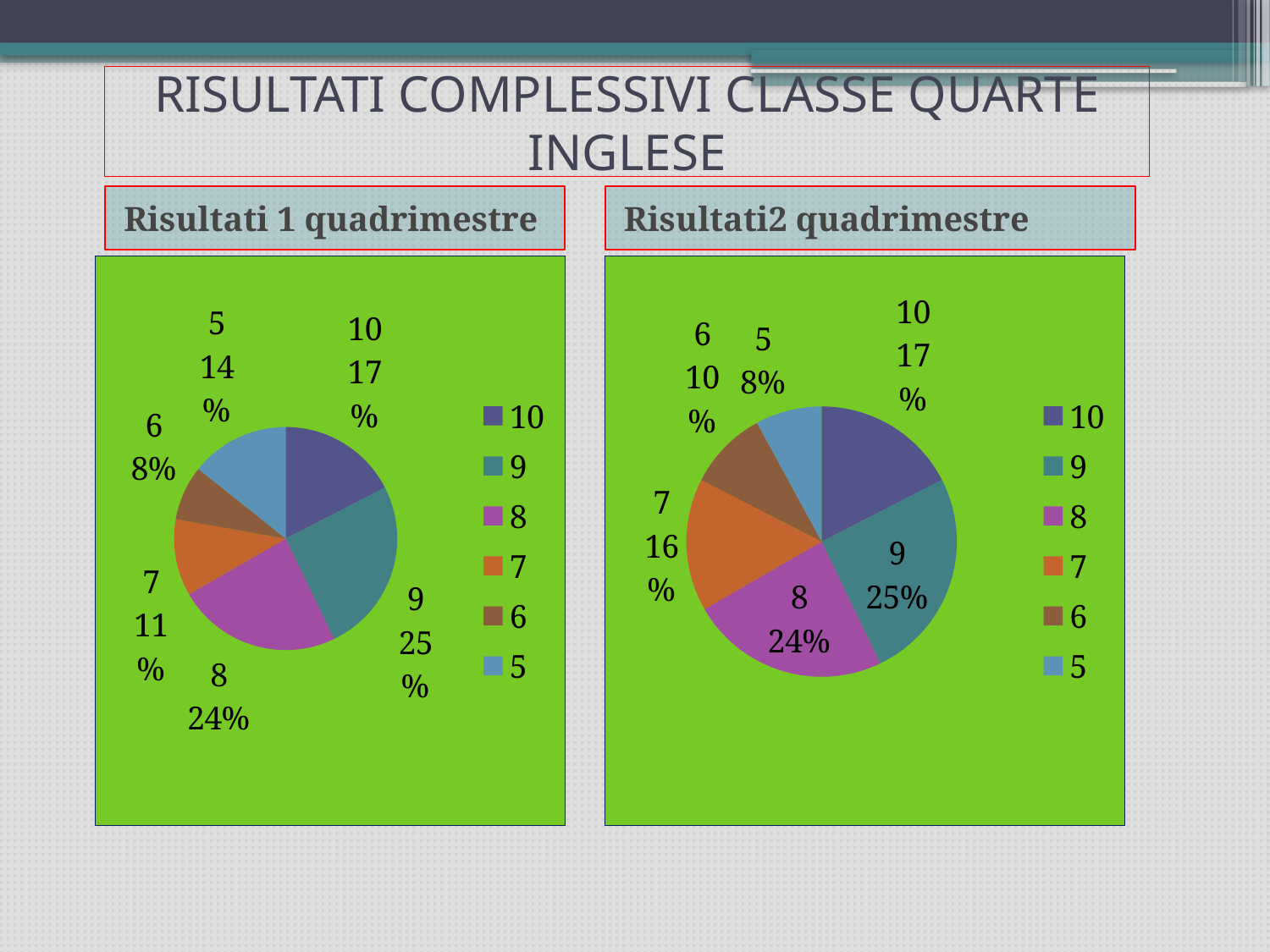
How many slices does the 'Risultati2 quadrimestre' pie chart have? 6 In the 'Risultati2 quadrimestre' chart, what percentage is shown for grade 6? 10% What type of chart is used for 'Risultati 1 quadrimestre'? Pie chart In the 'Risultati2 quadrimestre' chart, what percentage is shown for grade 7? 16% In the 'Risultati 1 quadrimestre' chart, which grade has the smallest share? 6 In the 'Risultati 1 quadrimestre' chart, what percentage is shown for grade 9? 25% In the 'Risultati 1 quadrimestre' chart, which grade has the largest share? 9 In the 'Risultati2 quadrimestre' chart, what is the difference in percentage points between grade 9 and grade 7? 9 How many entries does the legend of the 'Risultati 1 quadrimestre' chart list? 6 In the 'Risultati2 quadrimestre' chart, which grade has the smallest share? 5 In the 'Risultati 1 quadrimestre' chart, which is larger: the share for grade 5 or the share for grade 7? 5 In the 'Risultati 1 quadrimestre' chart, what percentage is shown for grade 5? 14%